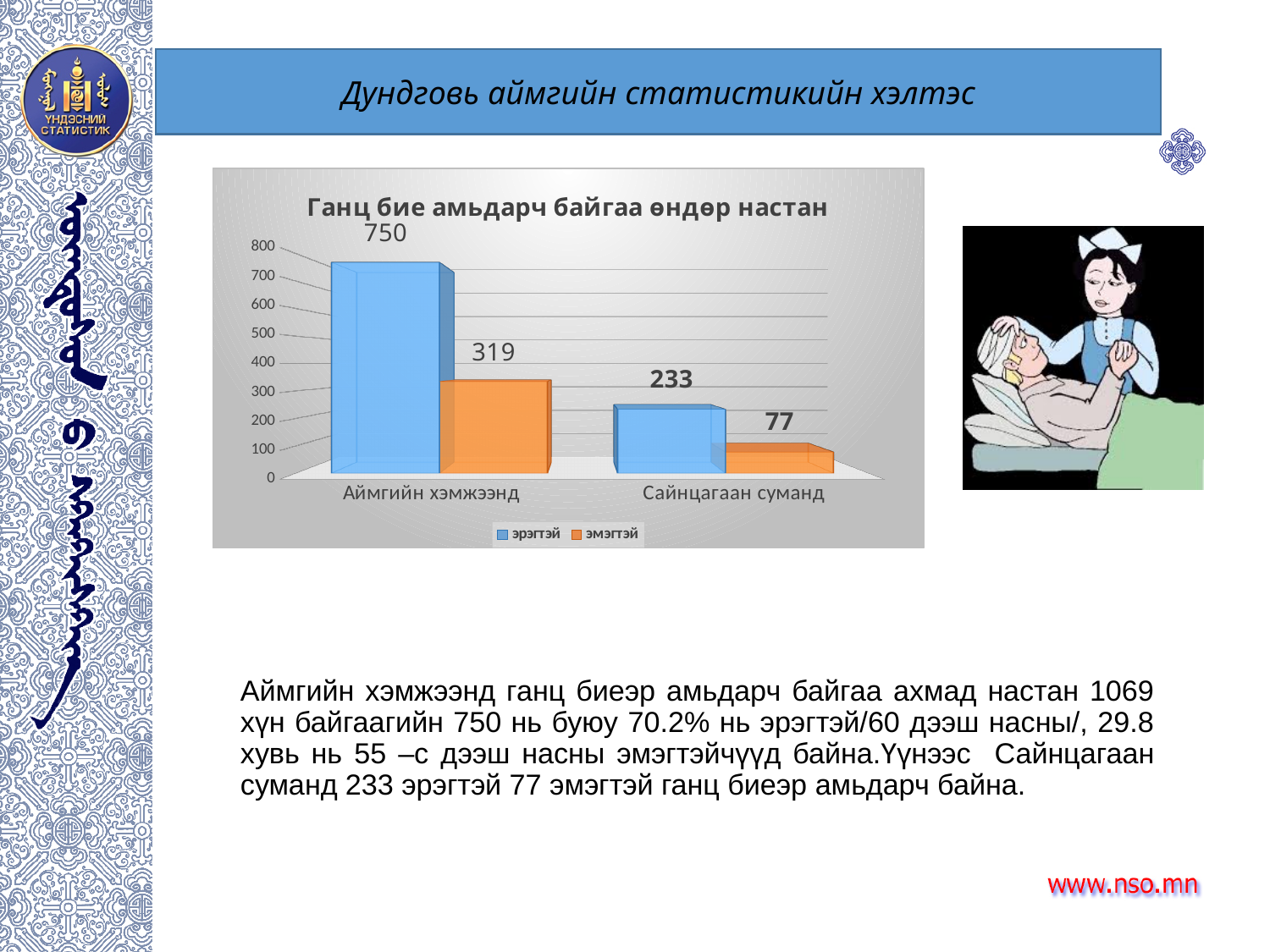
What is the difference between the эрэгтэй and эмэгтэй values in the Аймгийн хэмжээнд category? 431 What is the value for эрэгтэй in the Аймгийн хэмжээнд category? 750 How many series does the legend list? 2 What kind of chart is shown on the slide? bar chart Which is larger: the эмэгтэй value for Аймгийн хэмжээнд or the эрэгтэй value for Сайнцагаан суманд? эмэгтэй value for Аймгийн хэмжээнд What is the value for эмэгтэй in the Сайнцагаан суманд category? 77 What is the value for эмэгтэй in the Аймгийн хэмжээнд category? 319 What is the difference between the эрэгтэй and эмэгтэй values in the Сайнцагаан суманд category? 156 What is the value for эрэгтэй in the Сайнцагаан суманд category? 233 How many categories are shown on the x axis? 2 Which series has the lowest value in the Сайнцагаан суманд category? эмэгтэй Which category has the highest эрэгтэй value? Аймгийн хэмжээнд